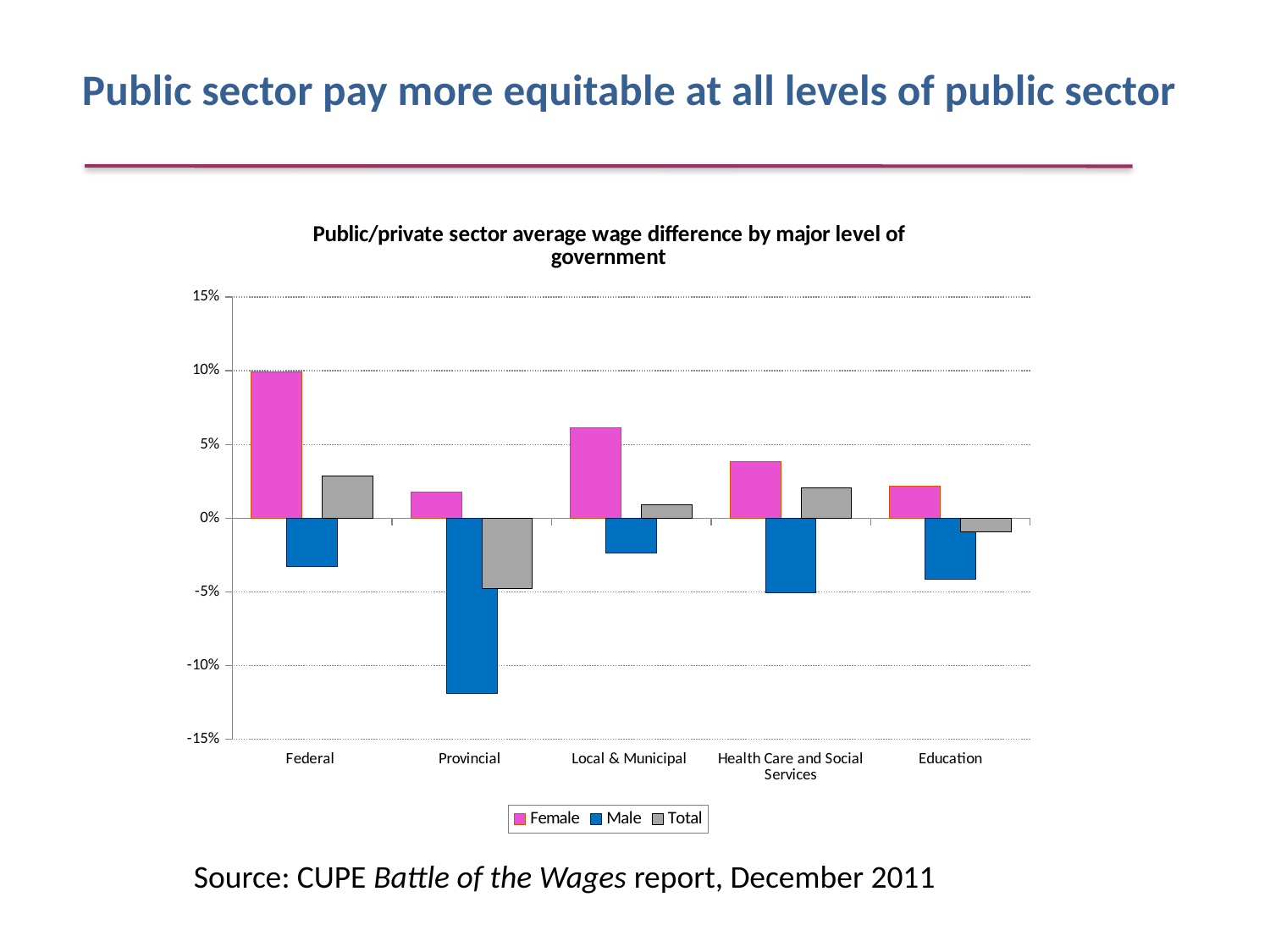
Which colour represents the Male series in the chart? Blue Which level of government has the lowest Total value? Provincial Is the Male value for Provincial greater or less than -10%? less Which level of government has the highest Female value? Federal Which level of government has the lowest Male value? Provincial Is the Female value for Federal greater or less than 5%? greater What is the title of the chart? Public/private sector average wage difference by major level of government How many series does the chart's legend list? 3 Which is larger, the Female value for Federal or the Female value for Local & Municipal? Federal Is the Male value for Education greater or less than -5%? greater What kind of chart is shown on the slide? Bar chart How many levels of government are shown on the x axis of the chart? 5